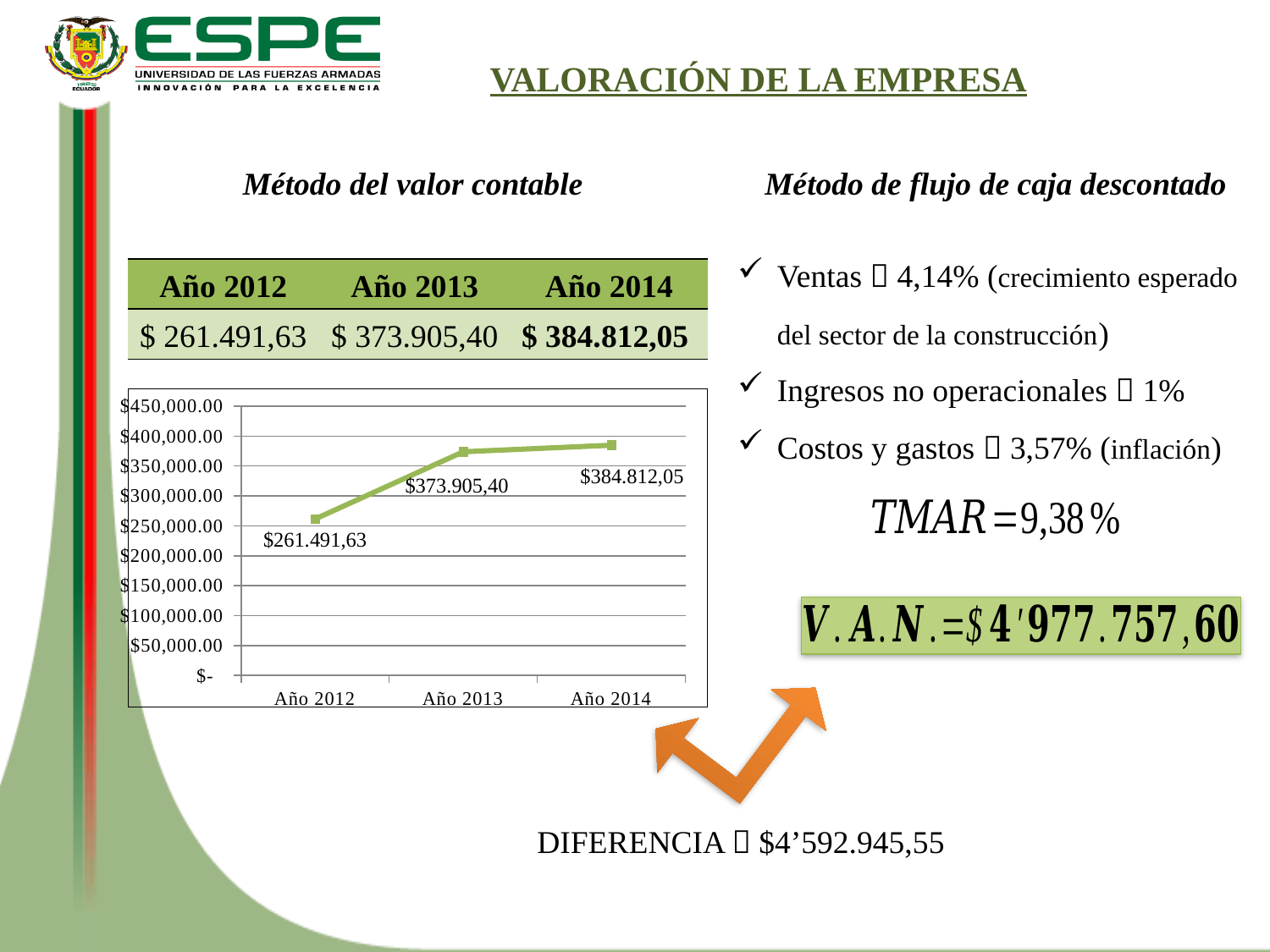
Do the values in the line chart rise or fall from Año 2012 to Año 2014? rise Which year has the highest value in the line chart? Año 2014 What is the value for Año 2014 in the line chart? $384.812,05 How many data points are plotted in the line chart? 3 Which is larger in the line chart, the value for Año 2012 or the value for Año 2013? Año 2013 Which year has the lowest value in the line chart? Año 2012 What is the difference between the values for Año 2014 and Año 2013 in the line chart? $10.906,65 What is the value for Año 2012 in the line chart? $261.491,63 What is the difference between the values for Año 2013 and Año 2012 in the line chart? $112.413,77 What kind of chart is shown on the slide? line chart What is the value for Año 2013 in the line chart? $373.905,40 Is the value for Año 2012 in the line chart greater or less than $300,000.00? less